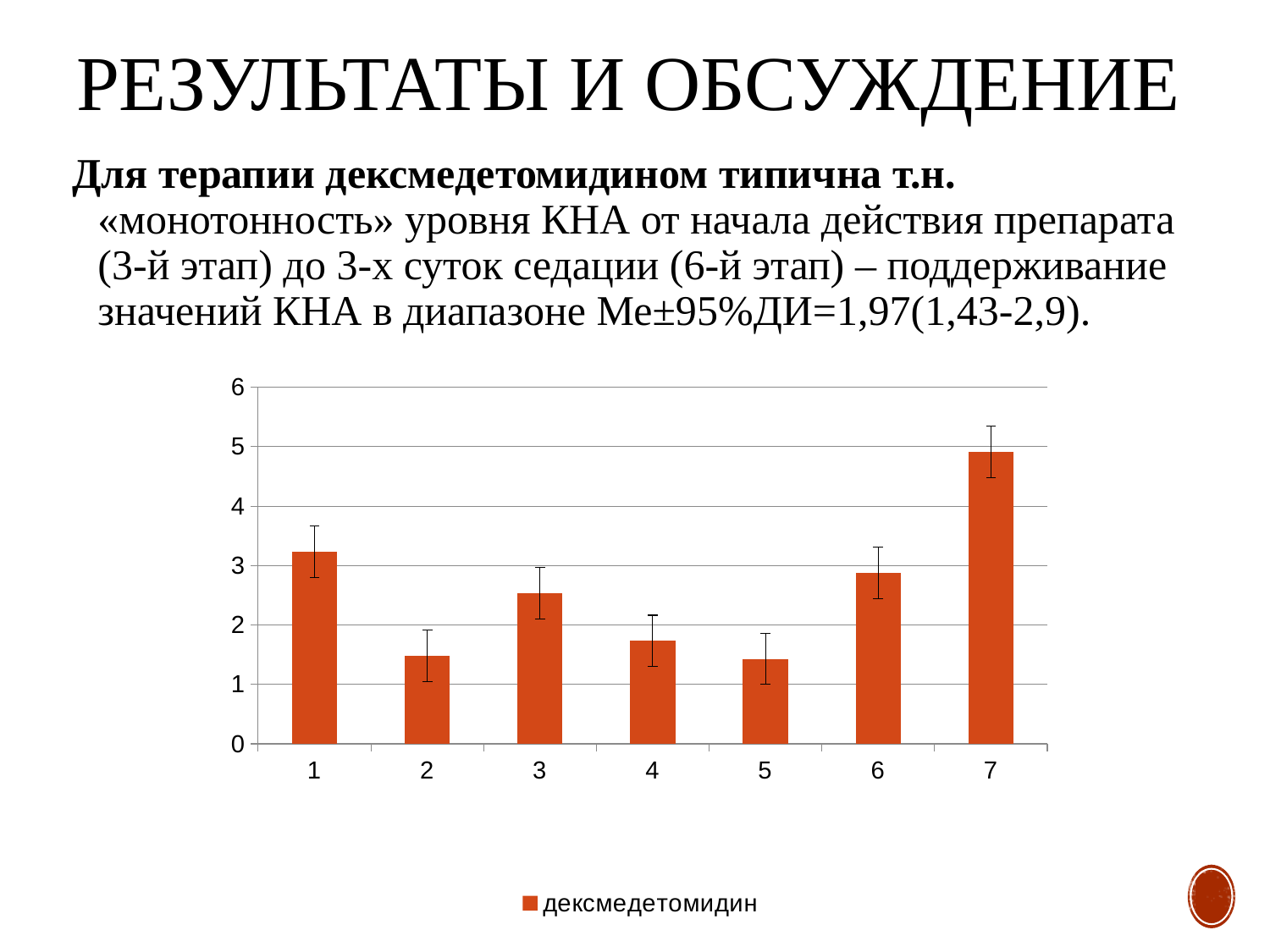
Is the value for category 2 greater or less than 2? less Is the value for category 7 greater or less than 4? greater Which has the larger value, category 6 or category 7? 7 Is the value for category 3 greater or less than 2? greater How many series does the chart legend list? 1 Which has the larger value, category 1 or category 2? 1 What is the name of the series shown in the chart legend? дексмедетомидин What kind of chart is shown on the slide? bar chart Which category has the highest bar in the chart? 7 How many categories are plotted along the x axis of the chart? 7